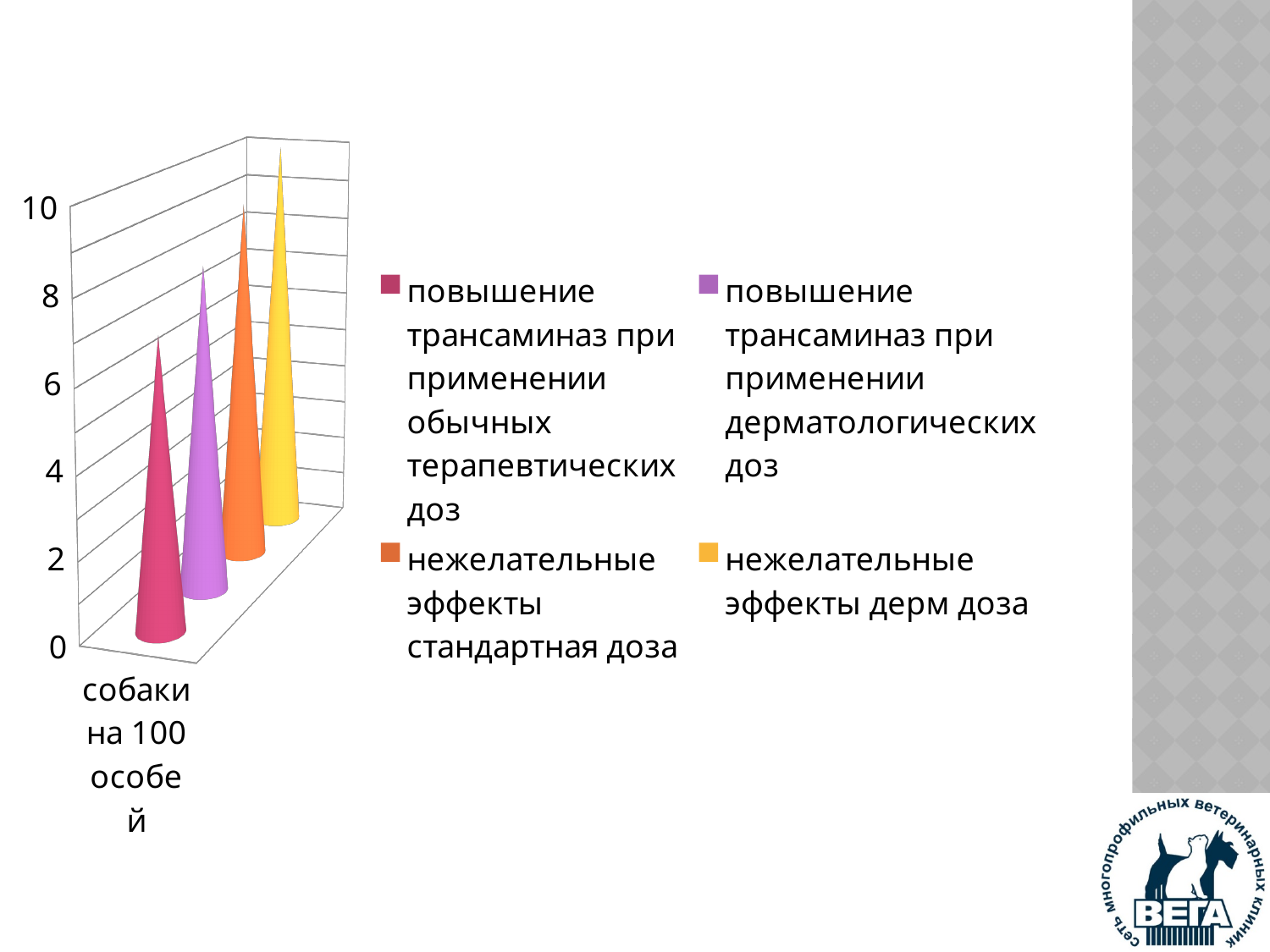
Do the values rise or fall going from the leftmost series to the rightmost series? rise Which series has the lowest value? повышение трансаминаз при применении обычных терапевтических доз How many series does the legend list? 4 Is the value for 'нежелательные эффекты стандартная доза' greater or less than 6? greater How many categories are plotted on the x axis? 1 Is the value for 'нежелательные эффекты дерм доза' greater or less than 8? greater What is the label of the category on the x axis? собаки на 100 особей What kind of chart is shown on the slide? bar chart Which is larger: the value for 'повышение трансаминаз при применении обычных терапевтических доз' or the value for 'нежелательные эффекты дерм доза'? нежелательные эффекты дерм доза What colour represents the series 'нежелательные эффекты стандартная доза'? orange Is the value for 'повышение трансаминаз при применении обычных терапевтических доз' greater or less than 4? greater Which series has the highest value? нежелательные эффекты дерм доза